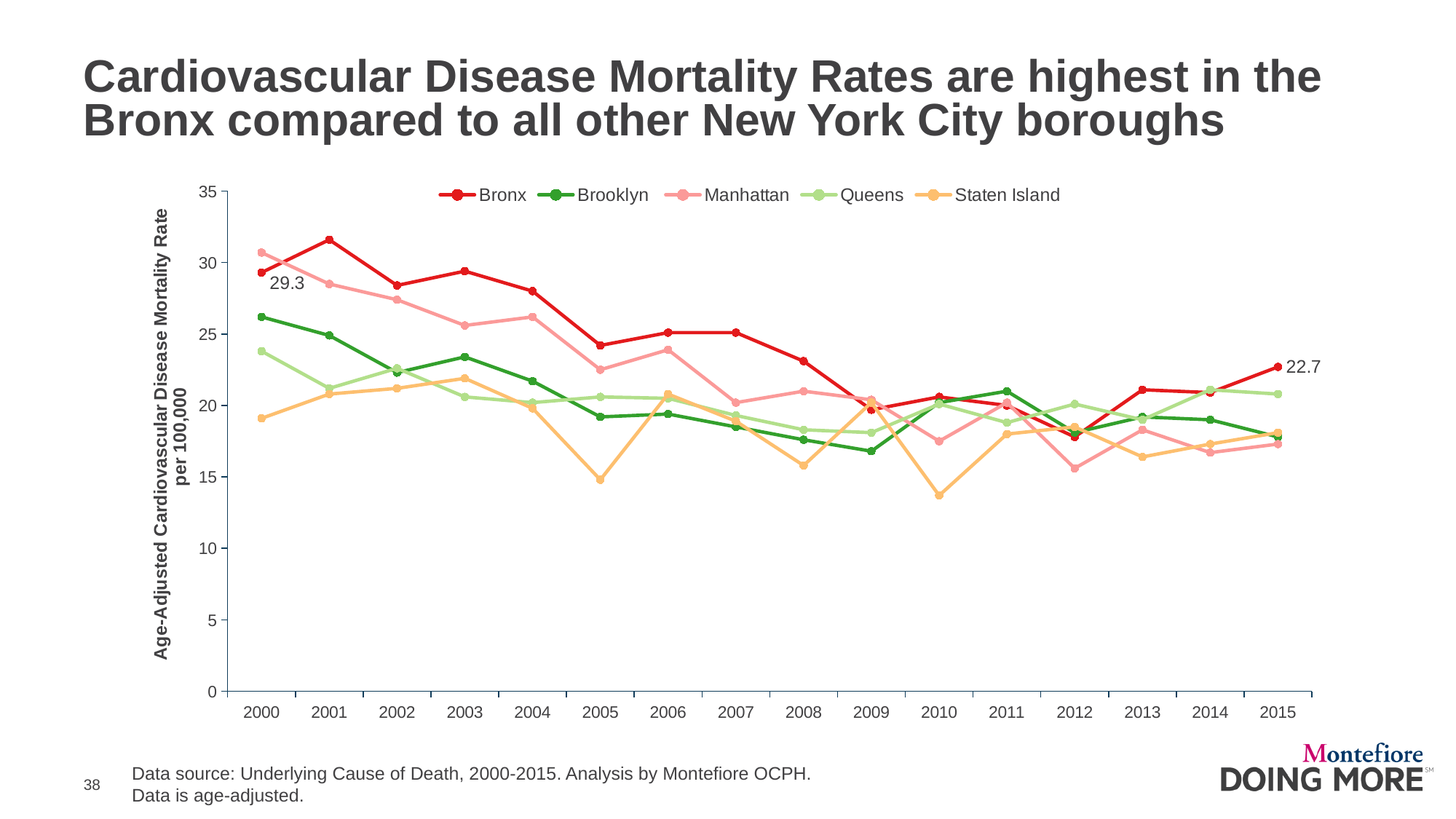
Does the Bronx mortality rate rise or fall overall from 2000 to 2015? fall Is the value for Staten Island in 2010 greater or less than 15? less What is the Bronx cardiovascular disease mortality rate in 2000? 29.3 How many years are shown along the x axis? 16 Is the value for the Bronx in 2001 greater or less than 30? greater What kind of chart is shown on the slide? line chart By how much did the Bronx mortality rate fall from 2000 to 2015? 6.6 How many series does the legend list? 5 Which borough has the highest mortality rate in 2001? Bronx In 2005, which is higher: the Bronx or Staten Island? Bronx What is the Bronx cardiovascular disease mortality rate in 2015? 22.7 Which borough has the lowest mortality rate in 2010? Staten Island